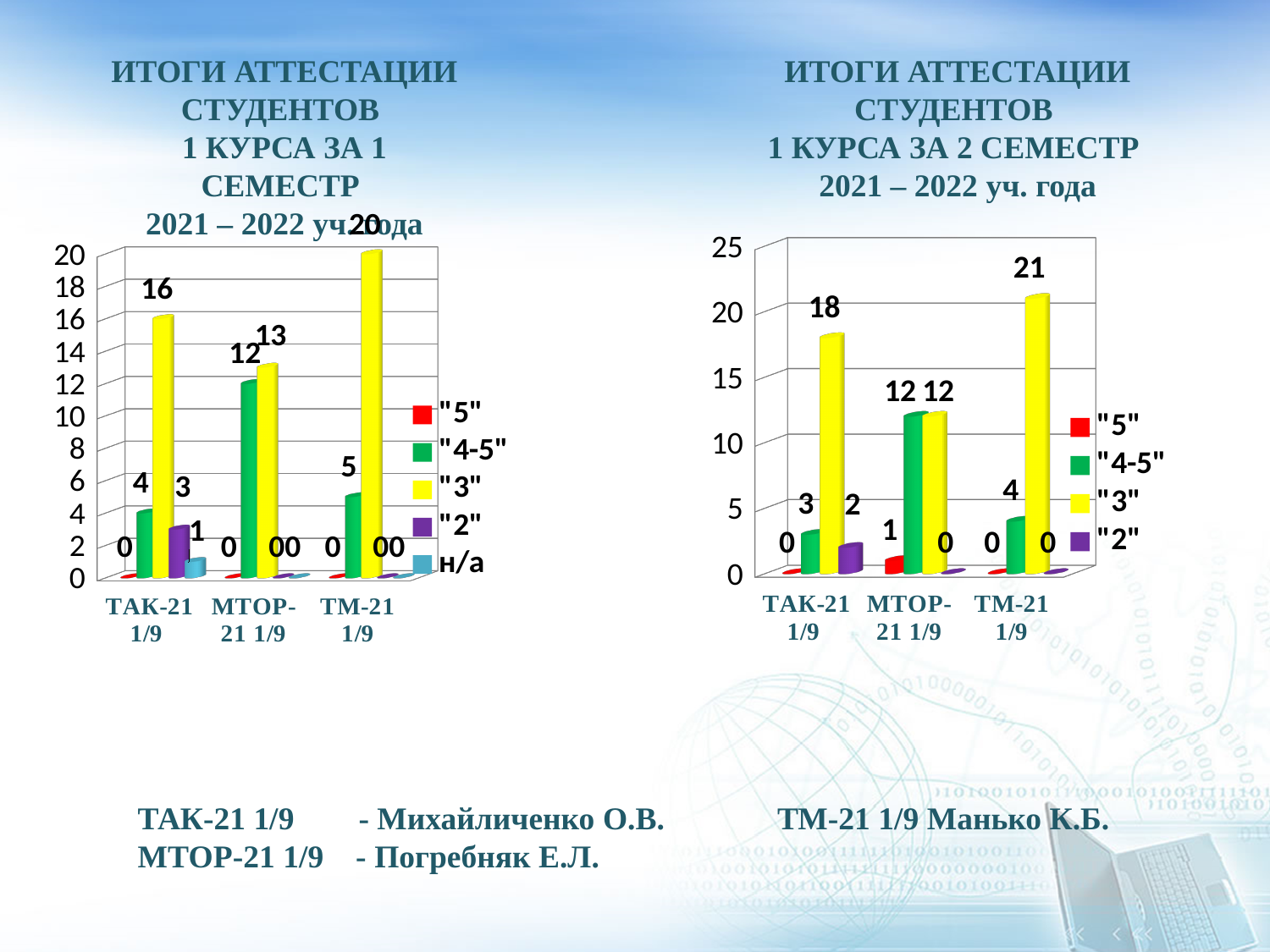
On the left chart (1 семестр), what is the value of the "3" series for ТМ-21 1/9? 20 On the right chart (2 семестр), what is the value of the "5" series for МТОР-21 1/9? 1 On the left chart (1 семестр), how many series does the legend list? 5 On the left chart (1 семестр), what is the difference between the "3" values for ТМ-21 1/9 and ТАК-21 1/9? 4 What type of chart is the right chart (2 семестр)? Bar chart On the right chart (2 семестр), how many groups are shown on the x axis? 3 On the right chart (2 семестр), which group has the lowest value in the "4-5" series? ТАК-21 1/9 On the left chart (1 семестр), what is the value of the "4-5" series for МТОР-21 1/9? 12 On the left chart (1 семестр), which group has the highest value in the "3" series? ТМ-21 1/9 On the right chart (2 семестр), what is the value of the "3" series for ТМ-21 1/9? 21 On the left chart (1 семестр), what is the value of the "2" series for ТАК-21 1/9? 3 On the right chart (2 семестр), which is larger: the "3" value for ТАК-21 1/9 or for МТОР-21 1/9? ТАК-21 1/9